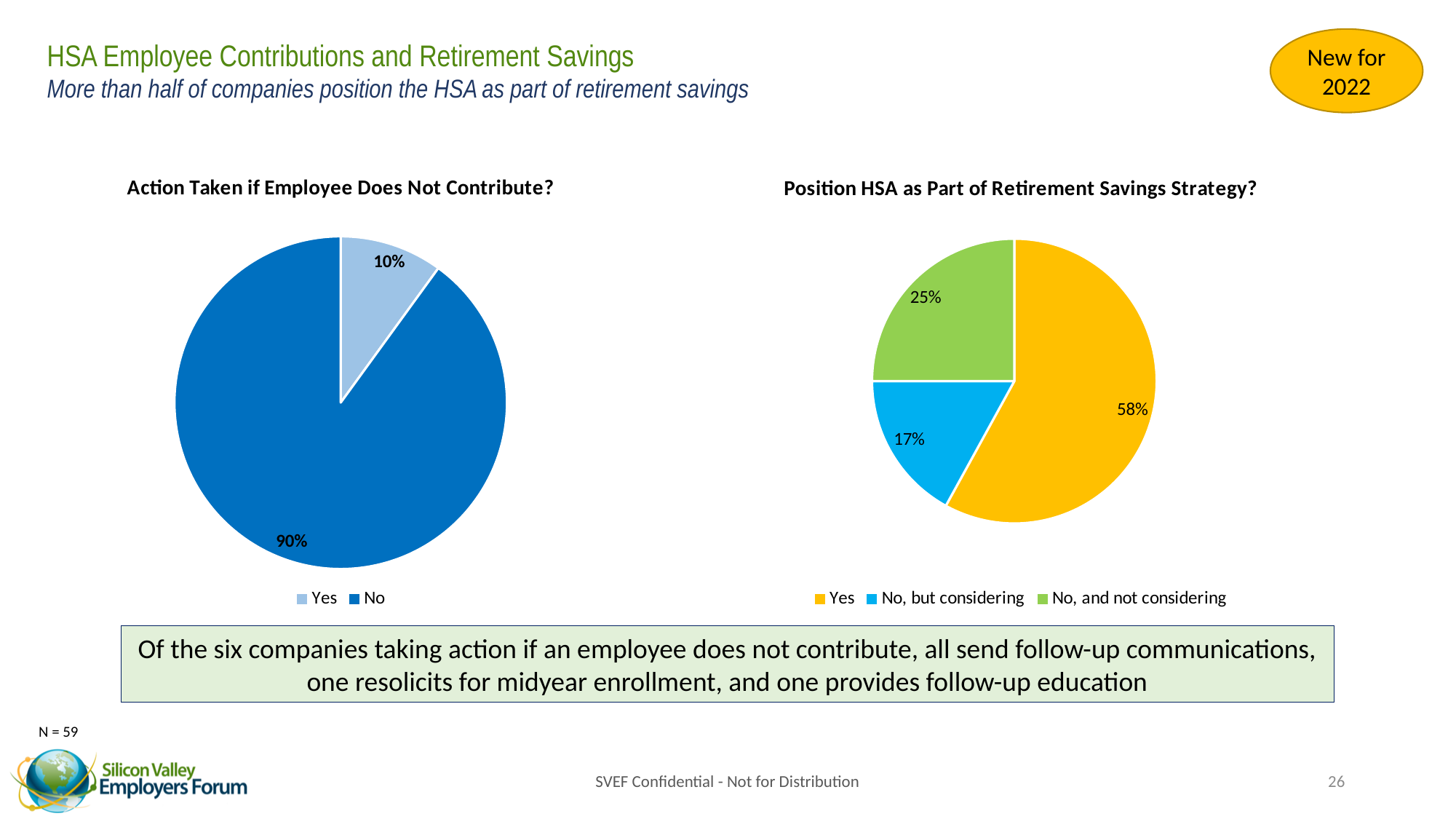
In the 'Position HSA as Part of Retirement Savings Strategy?' chart, which response has the smallest slice? No, but considering In the 'Position HSA as Part of Retirement Savings Strategy?' chart, what share of companies answered Yes? 58% In the 'Action Taken if Employee Does Not Contribute?' chart, what is the difference in percentage points between No and Yes? 80 percentage points In the 'Position HSA as Part of Retirement Savings Strategy?' chart, which is larger: 'No, and not considering' or 'No, but considering'? No, and not considering In the 'Action Taken if Employee Does Not Contribute?' chart, what share of companies answered Yes? 10% How many categories does the legend of the 'Position HSA as Part of Retirement Savings Strategy?' chart list? 3 What type of chart is the 'Action Taken if Employee Does Not Contribute?' chart? Pie chart In the 'Position HSA as Part of Retirement Savings Strategy?' chart, what is the difference in percentage points between 'No, and not considering' and 'No, but considering'? 8 percentage points In the 'Position HSA as Part of Retirement Savings Strategy?' chart, which response has the largest slice? Yes In the 'Position HSA as Part of Retirement Savings Strategy?' chart, what share answered 'No, but considering'? 17% In the 'Position HSA as Part of Retirement Savings Strategy?' chart, what share answered 'No, and not considering'? 25% In the 'Action Taken if Employee Does Not Contribute?' chart, what share of companies answered No? 90%